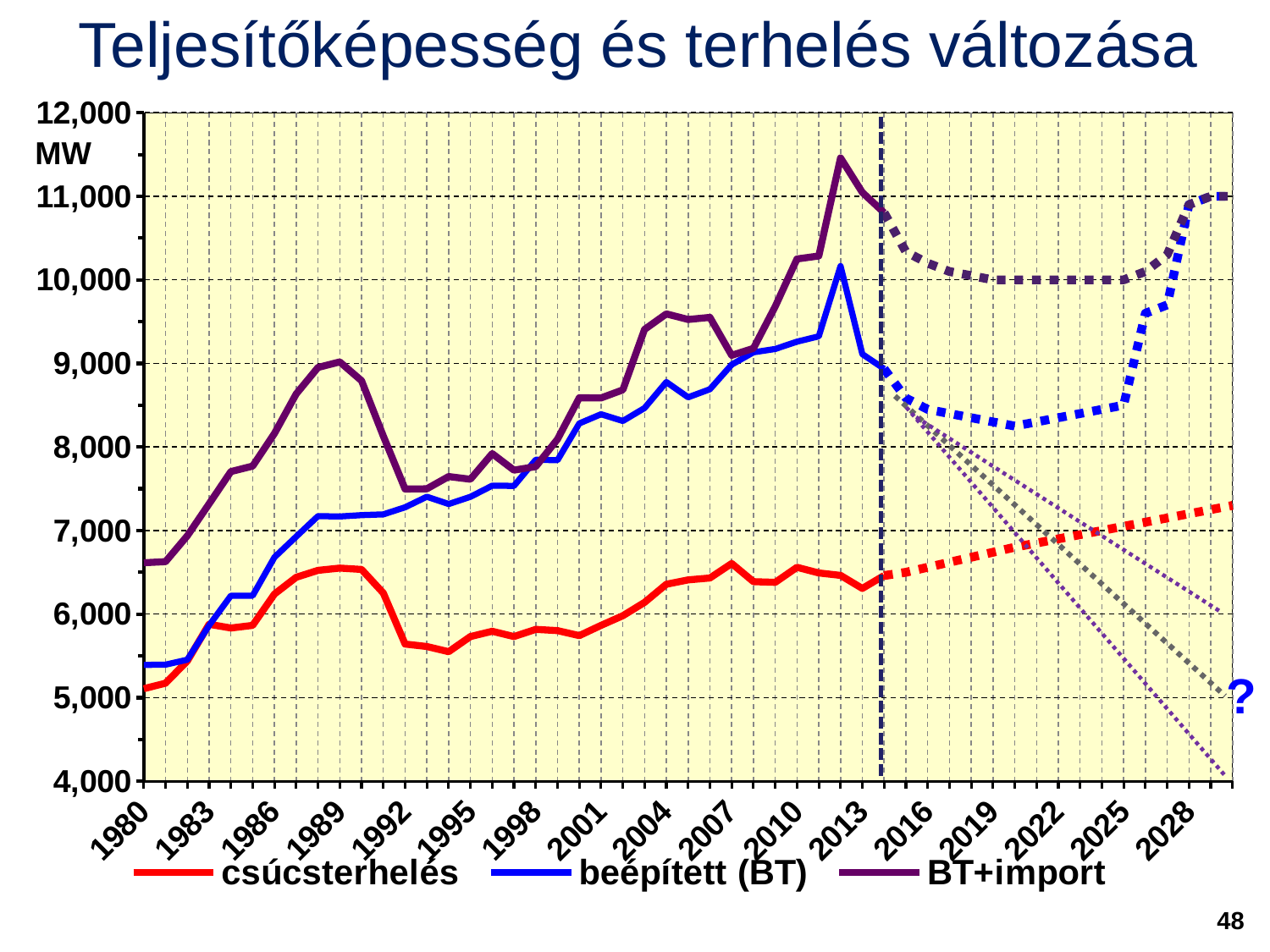
What are the three series named in the legend? csúcsterhelés, beépített (BT), BT+import Is the highest value reached by the beépített (BT) line greater or less than 10,000? greater Is the highest value reached by the BT+import line greater or less than 11,000? greater Is the value for beépített (BT) in 1980 greater or less than 6,000? less What unit is shown on the y axis? MW In 1989, which is higher: BT+import or csúcsterhelés? BT+import Which series stays lowest across the whole chart? csúcsterhelés How many series does the legend list? 3 What kind of chart is shown on the slide? line chart Which series reaches the highest value on the chart? BT+import